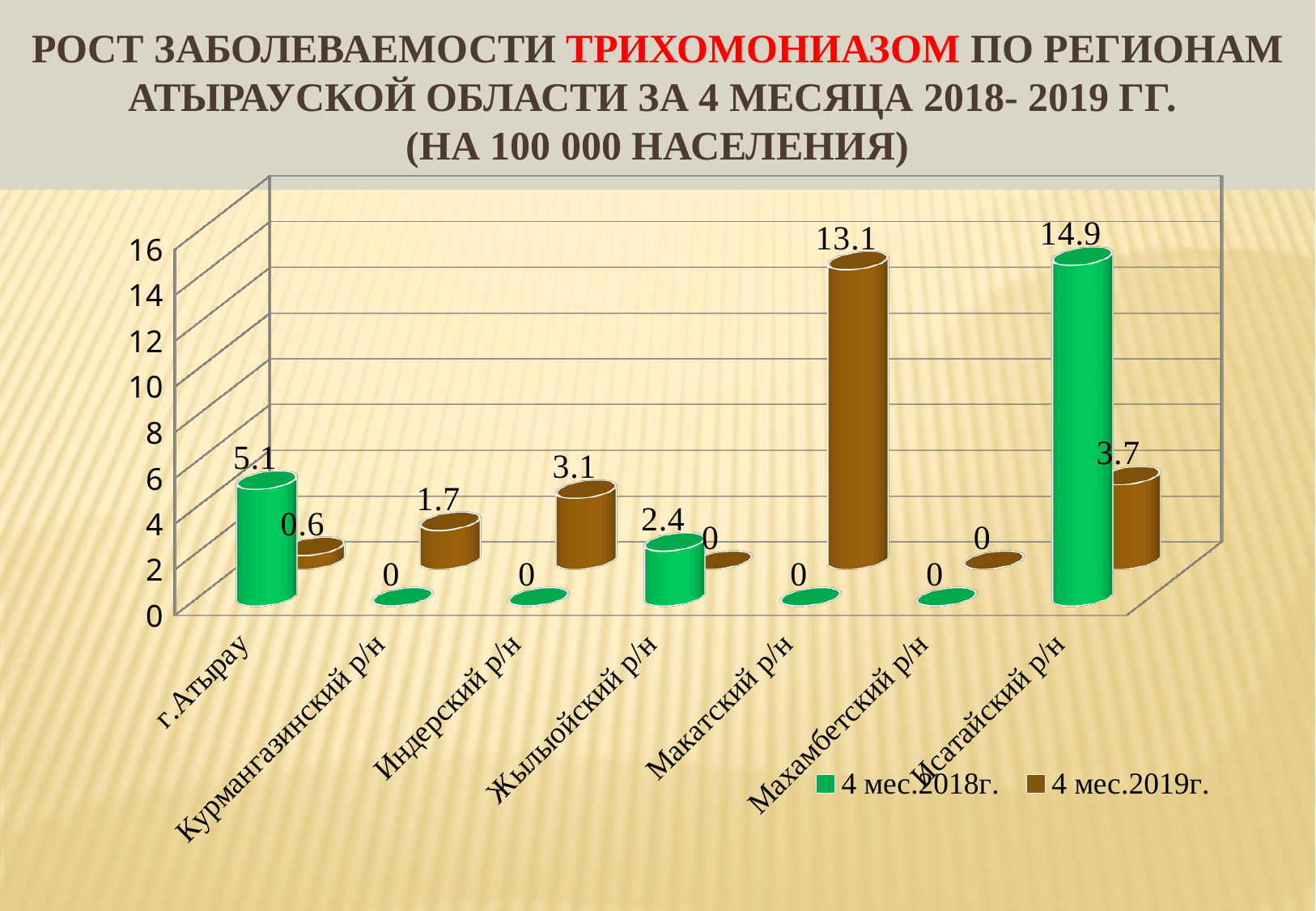
What kind of chart is shown on the slide? Bar chart How many regions are shown on the x axis? 7 Which region has the highest value in the 4 мес.2019г. series? Макатский р/н What is the value for г.Атырау in the 4 мес.2018г. series? 5.1 What is the value for Исатайский р/н in the 4 мес.2019г. series? 3.7 What is the value for Махамбетский р/н in the 4 мес.2019г. series? 0 Which is larger for г.Атырау: the 4 мес.2018г. value or the 4 мес.2019г. value? 4 мес.2018г. Which colour represents the 4 мес.2019г. series? Brown What is the difference between the 4 мес.2018г. and 4 мес.2019г. values for Исатайский р/н? 11.2 Which region has the highest value in the 4 мес.2018г. series? Исатайский р/н What is the value for Индерский р/н in the 4 мес.2019г. series? 3.1 How many series does the legend list? 2